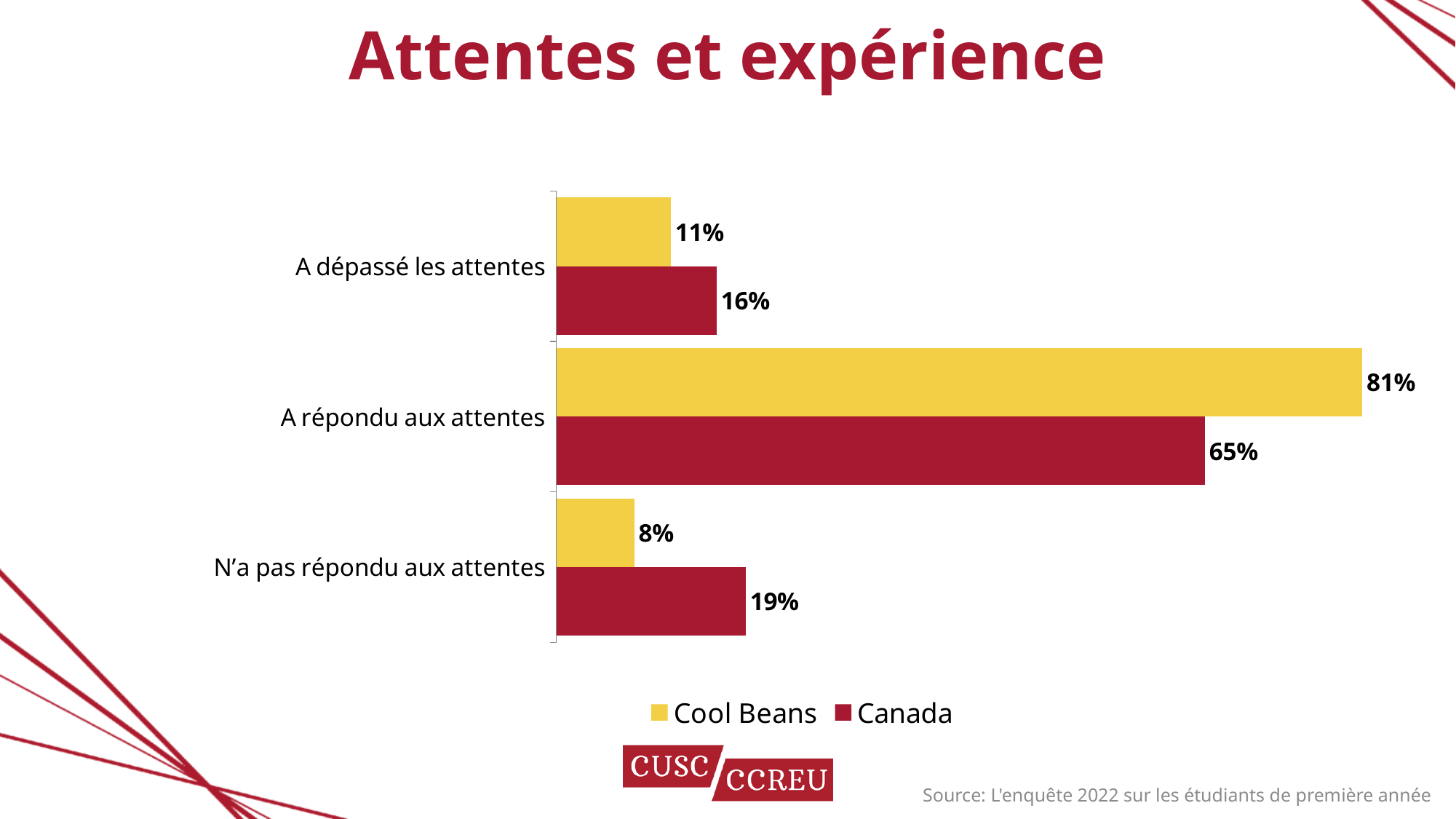
For "A dépassé les attentes", which series has the larger value, Cool Beans or Canada? Canada What is the Canada value for "N'a pas répondu aux attentes"? 19% How many series does the legend list? 2 What is the Cool Beans value for "A répondu aux attentes"? 81% What is the Canada value for "A dépassé les attentes"? 16% What is the Cool Beans value for "N'a pas répondu aux attentes"? 8% How many categories are shown on the chart? 3 What is the difference between the Canada and Cool Beans values for "N'a pas répondu aux attentes"? 11% Which category has the lowest Canada value? A dépassé les attentes Which category has the highest Cool Beans value? A répondu aux attentes What kind of chart is shown on the slide? Bar chart What is the difference between the Cool Beans and Canada values for "A répondu aux attentes"? 16%